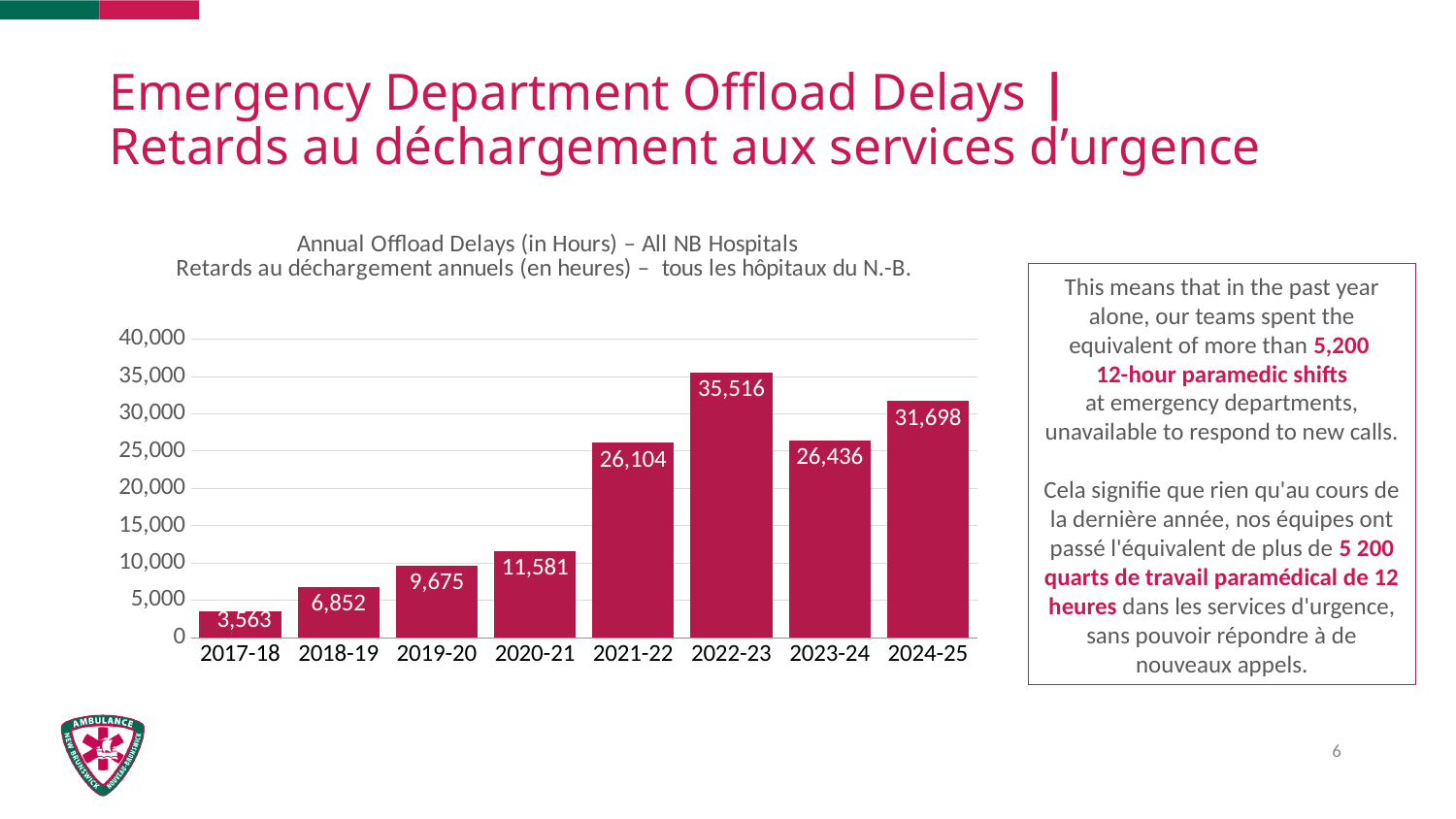
Do the offload delay values generally rise or fall from 2017-18 to 2022-23? rise What is the annual offload delay value for 2022-23? 35,516 What is the annual offload delay value for 2024-25? 31,698 Which year has a larger offload delay value, 2020-21 or 2019-20? 2020-21 What is the annual offload delay value for 2017-18? 3,563 How many years are shown on the x axis of the chart? 8 Which year has the highest annual offload delay? 2022-23 What kind of chart is shown on the slide? bar chart Is the value for 2021-22 greater or less than 25,000? greater Which year has the lowest annual offload delay? 2017-18 What is the difference between the offload delay values for 2022-23 and 2024-25? 3,818 What is the difference between the offload delay values for 2023-24 and 2021-22? 332